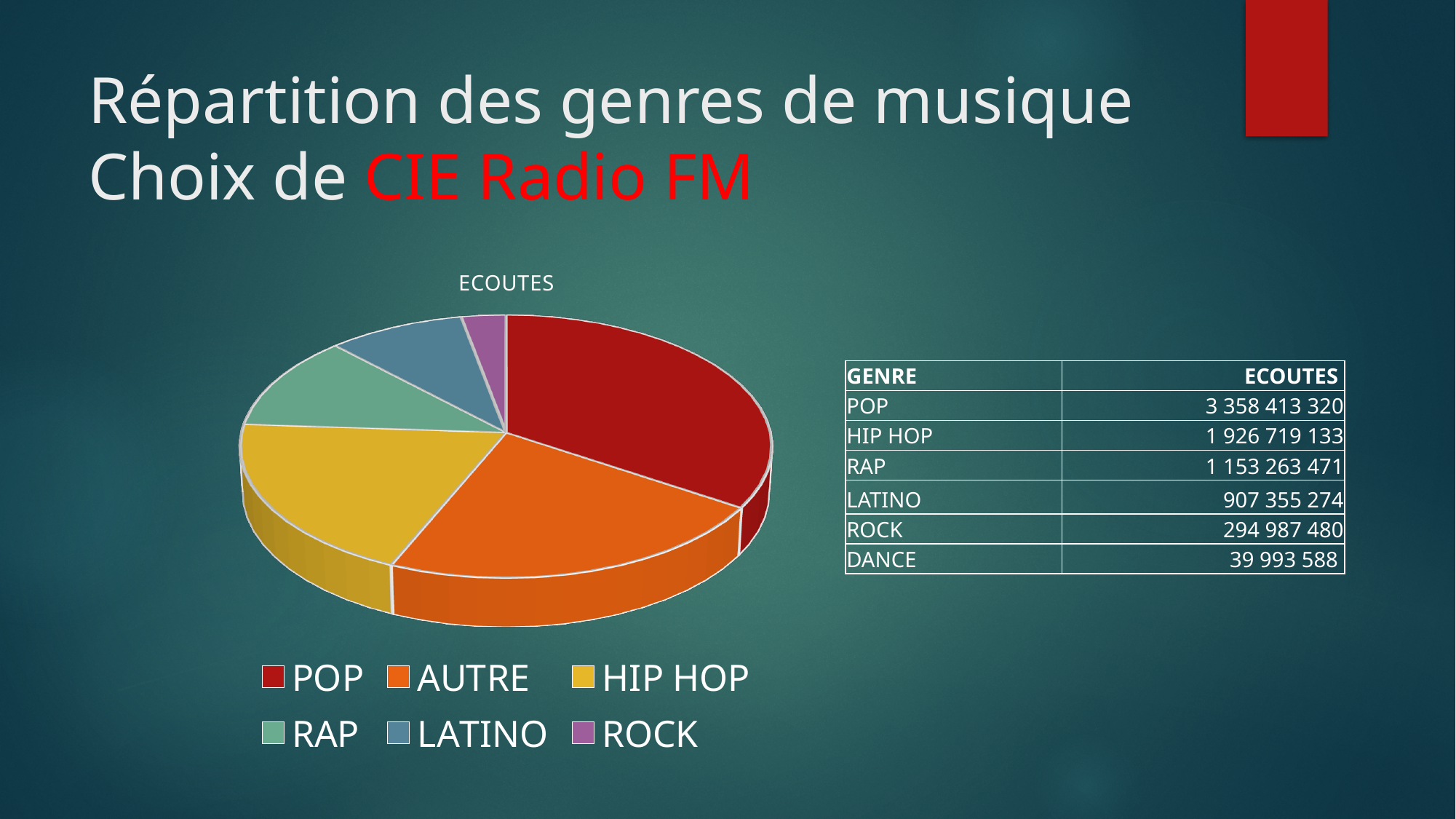
In the pie chart, which slice is larger, HIP HOP or RAP? HIP HOP Which category has the largest slice in the pie chart? POP What is the title of the pie chart? ECOUTES In the table next to the chart, how many ECOUTES are listed for DANCE? 39 993 588 In the pie chart, which slice is larger, POP or ROCK? POP Which category has the smallest slice in the pie chart? ROCK What kind of chart is shown on the slide? pie chart In the table next to the chart, how many ECOUTES are listed for POP? 3 358 413 320 In the pie chart, which slice is larger, AUTRE or LATINO? AUTRE Which colour represents POP in the pie chart? red How many slices does the pie chart have? 6 In the table next to the chart, how many ECOUTES are listed for ROCK? 294 987 480